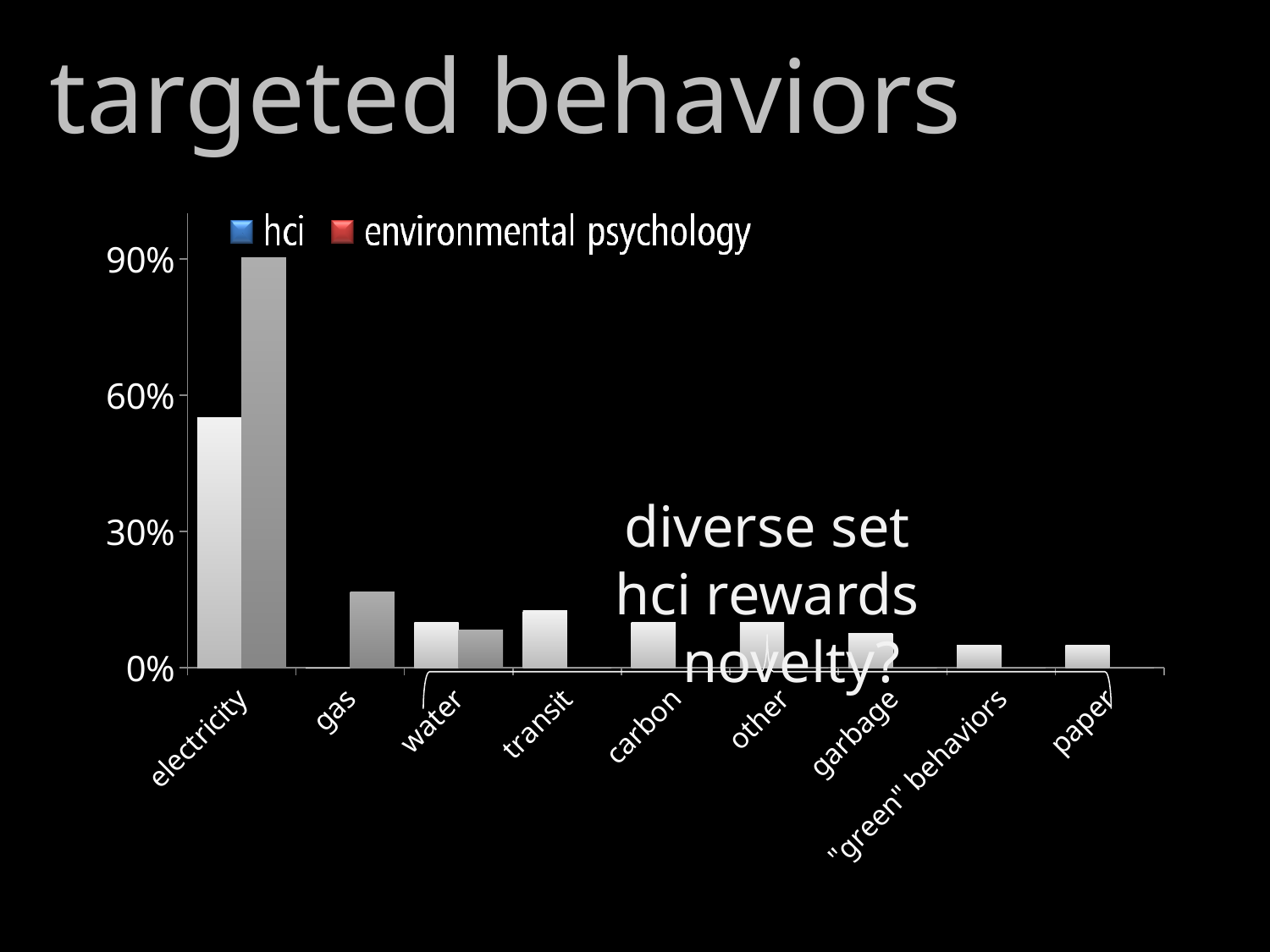
Which category has the highest value for the hci series? electricity Is the hci value for electricity greater or less than 30%? greater How many categories are shown along the x axis? 9 What kind of chart is shown on the slide? bar chart What are the two entries in the chart's legend? hci and environmental psychology For electricity, which series has the larger value, hci or environmental psychology? environmental psychology Do the hci values generally rise or fall moving from electricity to paper along the x axis? fall Is the environmental psychology value for gas greater or less than 30%? less Which category has the highest value for the environmental psychology series? electricity For the environmental psychology series, which is larger, electricity or gas? electricity How many series does the legend list? 2 Is the environmental psychology value for electricity greater or less than 60%? greater